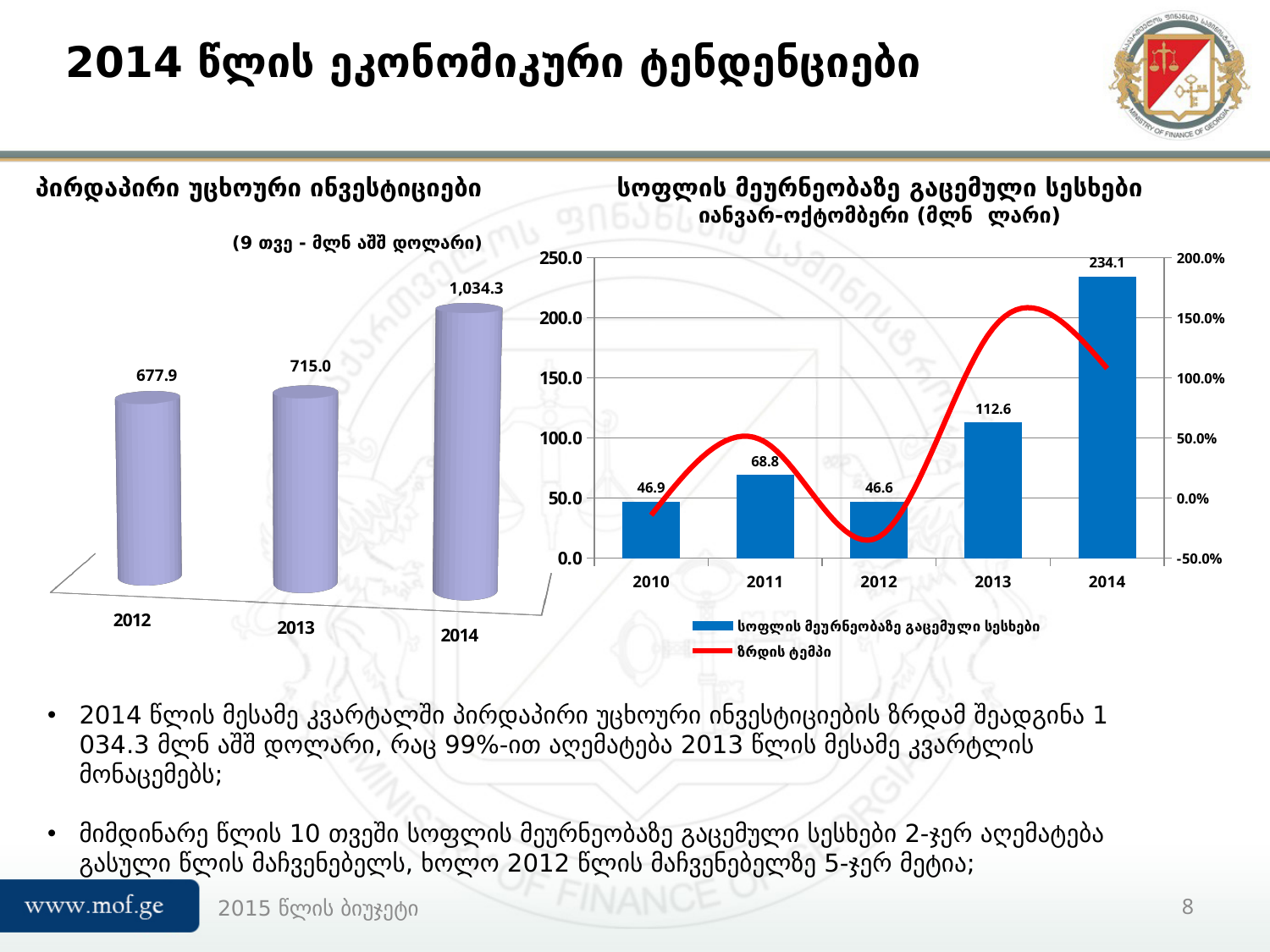
In the left chart (foreign direct investment), which year has the lowest value? 2012 In the right chart (agricultural loans), is the bar value for 2010 larger or smaller than the bar value for 2012? larger In the left chart (foreign direct investment), what is the value for 2012? 677.9 In the left chart (foreign direct investment), what is the value for 2014? 1,034.3 In the right chart (agricultural loans), how many series does the legend list? 2 In the right chart (agricultural loans), what is the bar value for 2011? 68.8 In the right chart (agricultural loans), what is the bar value for 2013? 112.6 In the right chart (agricultural loans), which year has the highest bar value? 2014 In the left chart (foreign direct investment), do the values rise or fall from 2012 to 2014? rise In the right chart (agricultural loans), what is the difference between the 2014 and 2013 bar values? 121.5 In the left chart (foreign direct investment), what is the difference between the 2014 and 2013 values? 319.3 In the left chart (foreign direct investment), how many years are shown? 3